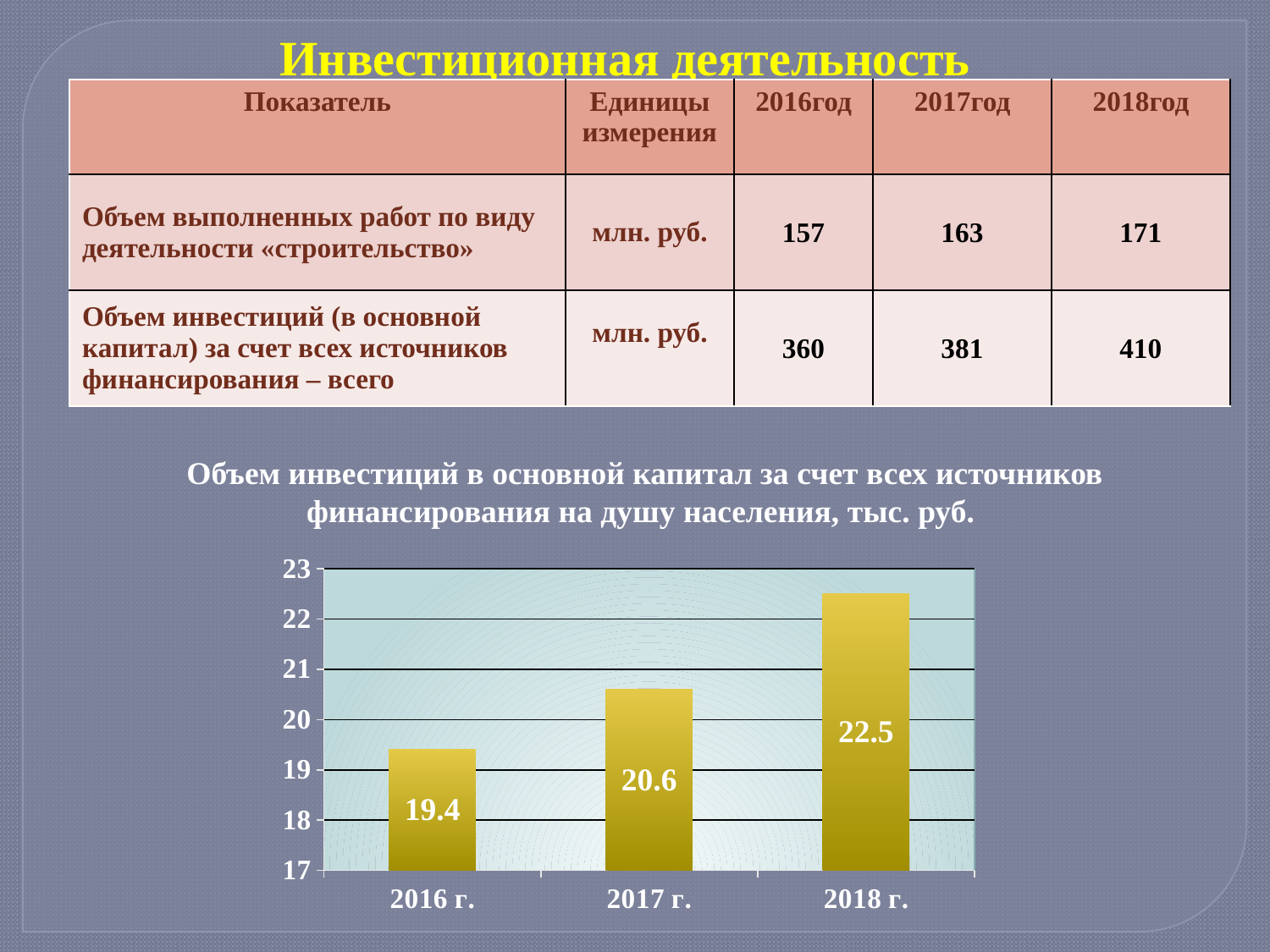
Do the values in the chart rise or fall from 2016 г. to 2018 г.? rise What is the value for 2016 г. in the chart? 19.4 What is the difference between the values for 2018 г. and 2016 г. in the chart? 3.1 What kind of chart is shown on the slide? bar chart What is the value for 2018 г. in the chart? 22.5 Is the value for 2017 г. greater or less than 21? less Which year has the highest value in the chart? 2018 г. What is the difference between the values for 2017 г. and 2016 г. in the chart? 1.2 How many bars are shown in the chart? 3 Which is larger in the chart, the value for 2017 г. or the value for 2018 г.? 2018 г. Which year has the lowest value in the chart? 2016 г. What is the value for 2017 г. in the chart? 20.6